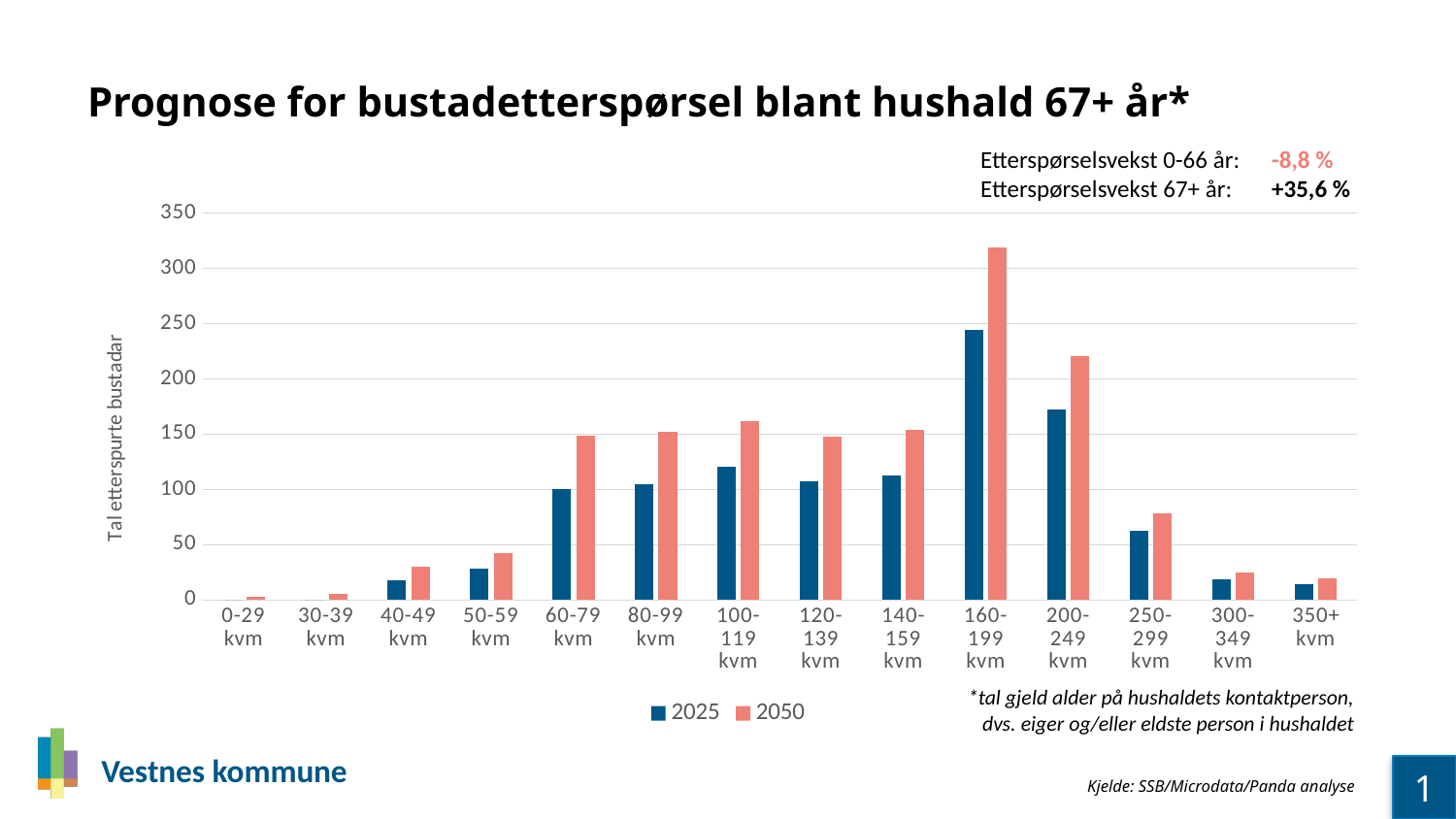
What is the label on the y axis of the chart? Tal etterspurte bustadar Is the 2025 value for 200-249 kvm greater or less than 150? greater Is the 2050 value for 250-299 kvm greater or less than 100? less For 2025, which is larger: the value for 160-199 kvm or for 200-249 kvm? 160-199 kvm Which size category has the lowest value for 2050? 0-29 kvm Is the 2050 value for 160-199 kvm greater or less than 300? greater Which size category has the highest value for 2050? 160-199 kvm For 160-199 kvm, which series has the larger value, 2025 or 2050? 2050 How many size categories are shown on the x axis? 14 What kind of chart is shown on the slide? bar chart Which size category has the highest value for 2025? 160-199 kvm How many series does the legend list? 2